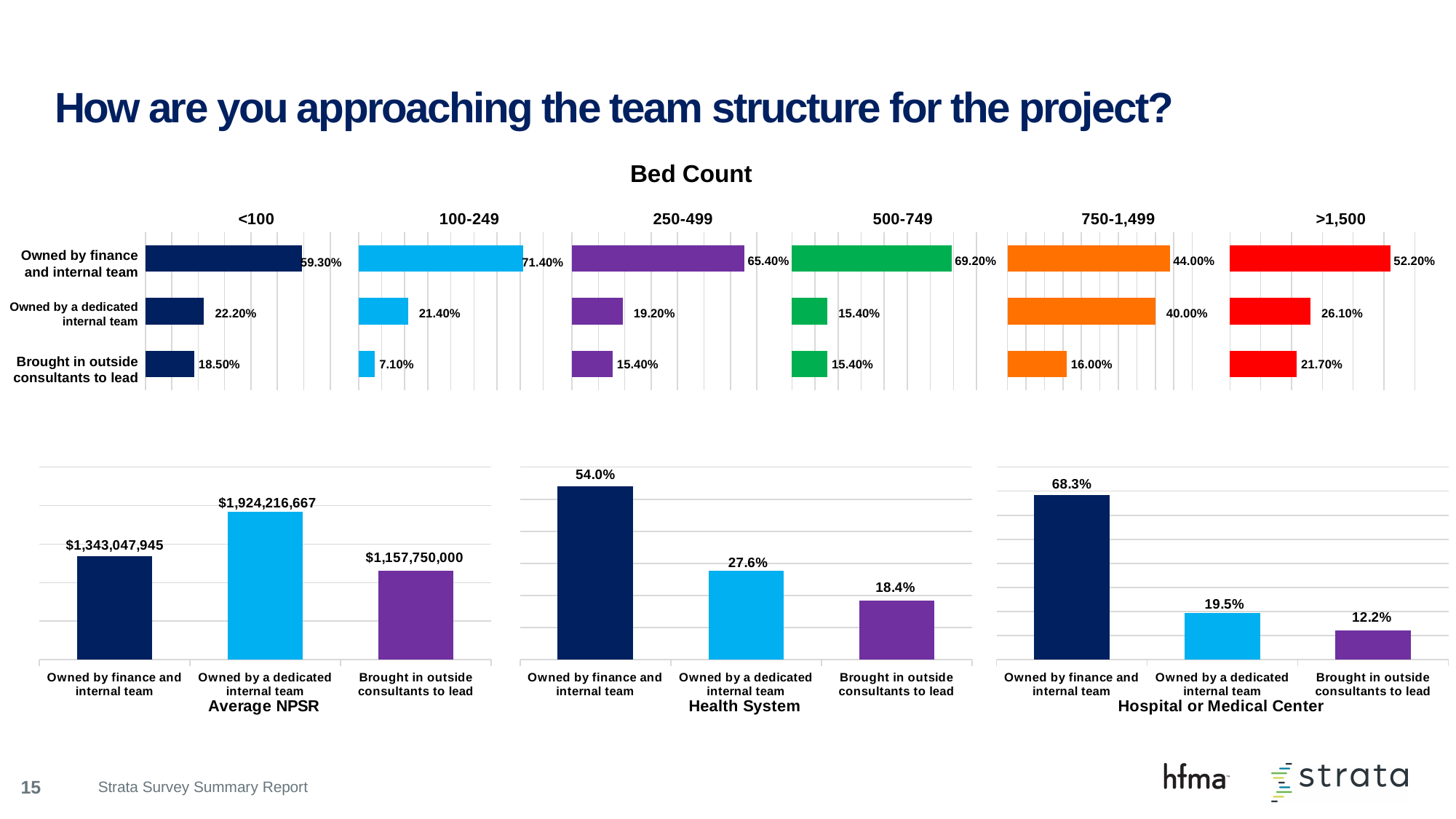
In the Bed Count chart, what is the value for 'Owned by finance and internal team' in the 100-249 bed group? 71.40% In the Average NPSR chart, what is the value for 'Owned by a dedicated internal team'? $1,924,216,667 In the Bed Count chart, which is larger for the >1,500 bed group: 'Owned by a dedicated internal team' or 'Brought in outside consultants to lead'? Owned by a dedicated internal team In the Bed Count chart, which bed-count group has the lowest value for 'Owned by finance and internal team'? 750-1,499 In the Average NPSR chart, which category has the lowest value? Brought in outside consultants to lead How many categories are shown in the Hospital or Medical Center chart? 3 What kind of chart is the Health System chart? Bar chart In the Hospital or Medical Center chart, what is the difference between 'Owned by finance and internal team' and 'Owned by a dedicated internal team'? 48.8% In the Bed Count chart, what is the difference between 'Owned by finance and internal team' and 'Owned by a dedicated internal team' in the 750-1,499 bed group? 4.00% In the Health System chart, what is the value for 'Brought in outside consultants to lead'? 18.4% In the Bed Count chart, which bed-count group has the highest value for 'Owned by finance and internal team'? 100-249 In the Bed Count chart, what is the value for 'Brought in outside consultants to lead' in the 100-249 bed group? 7.10%